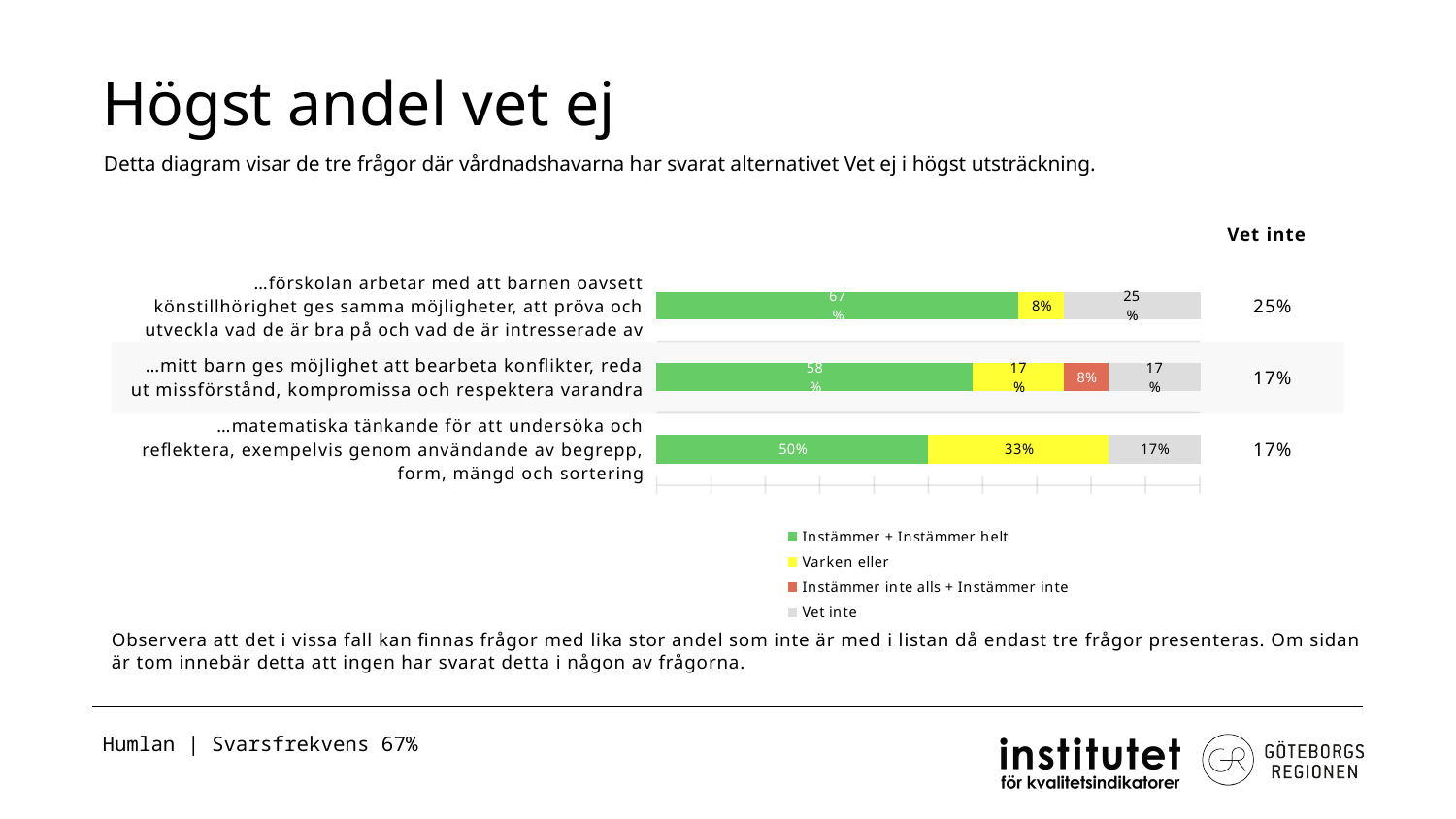
What is the 'Instämmer + Instämmer helt' value for the top bar (…förskolan arbetar med att barnen oavsett könstillhörighet…)? 67% What kind of chart is shown on the slide? stacked bar chart What is the 'Vet inte' value for the middle bar (…mitt barn ges möjlighet att bearbeta konflikter…)? 17% How many questions (bars) are shown in the chart? 3 Which legend entry is shown in grey? Vet inte Which question has the lowest 'Instämmer + Instämmer helt' share? …matematiska tänkande för att undersöka och reflektera, exempelvis genom användande av begrepp, form, mängd och sortering Which is larger: the 'Varken eller' value for the bottom bar or the 'Varken eller' value for the top bar? the bottom bar (33%) Which question has the highest 'Vet inte' share? …förskolan arbetar med att barnen oavsett könstillhörighet ges samma möjligheter, att pröva och utveckla vad de är bra på och vad de är intresserade av What is the 'Varken eller' value for the bottom bar (…matematiska tänkande för att undersöka och reflektera…)? 33% What is the difference between the 'Instämmer + Instämmer helt' values of the top bar (67%) and the bottom bar (50%)? 17 percentage points What is the 'Instämmer inte alls + Instämmer inte' value for the middle bar (…mitt barn ges möjlighet att bearbeta konflikter…)? 8% How many series does the legend list? 4